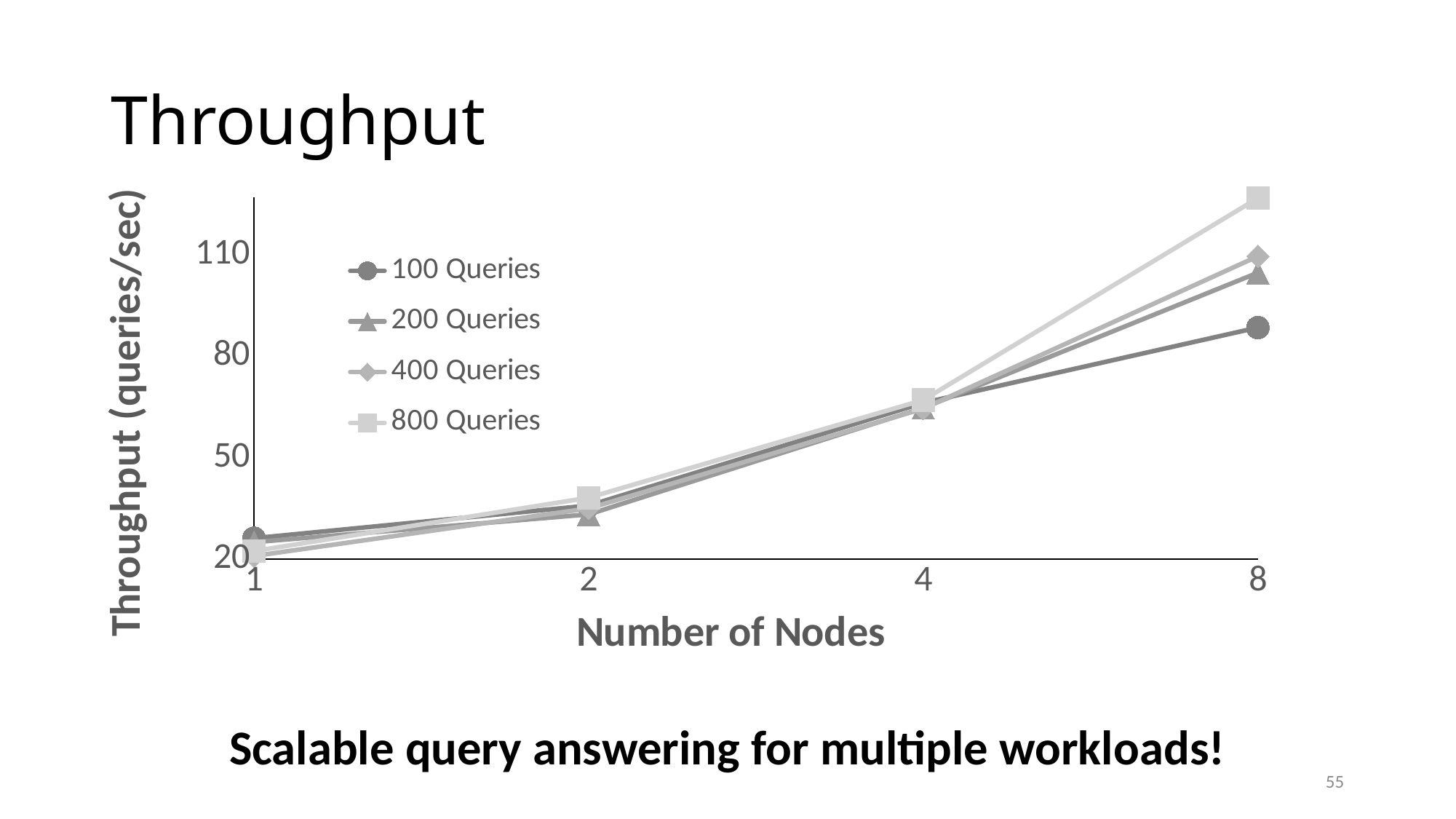
How many node counts are plotted along the x axis? 4 Is the throughput for 100 Queries at 8 nodes greater or less than 80? greater What is the title of the x axis? Number of Nodes Which series has the lowest throughput at 8 nodes? 100 Queries How many series does the legend list? 4 Which series has the highest throughput at 8 nodes? 800 Queries Is the throughput for 800 Queries at 8 nodes greater or less than 110? greater What is the title of the y axis? Throughput (queries/sec) What kind of chart is shown on the slide? line chart At 8 nodes, which has the higher throughput: 800 Queries or 100 Queries? 800 Queries Does the throughput for 800 Queries rise or fall as the number of nodes increases? rise Is the throughput for 800 Queries at 2 nodes greater or less than 50? less